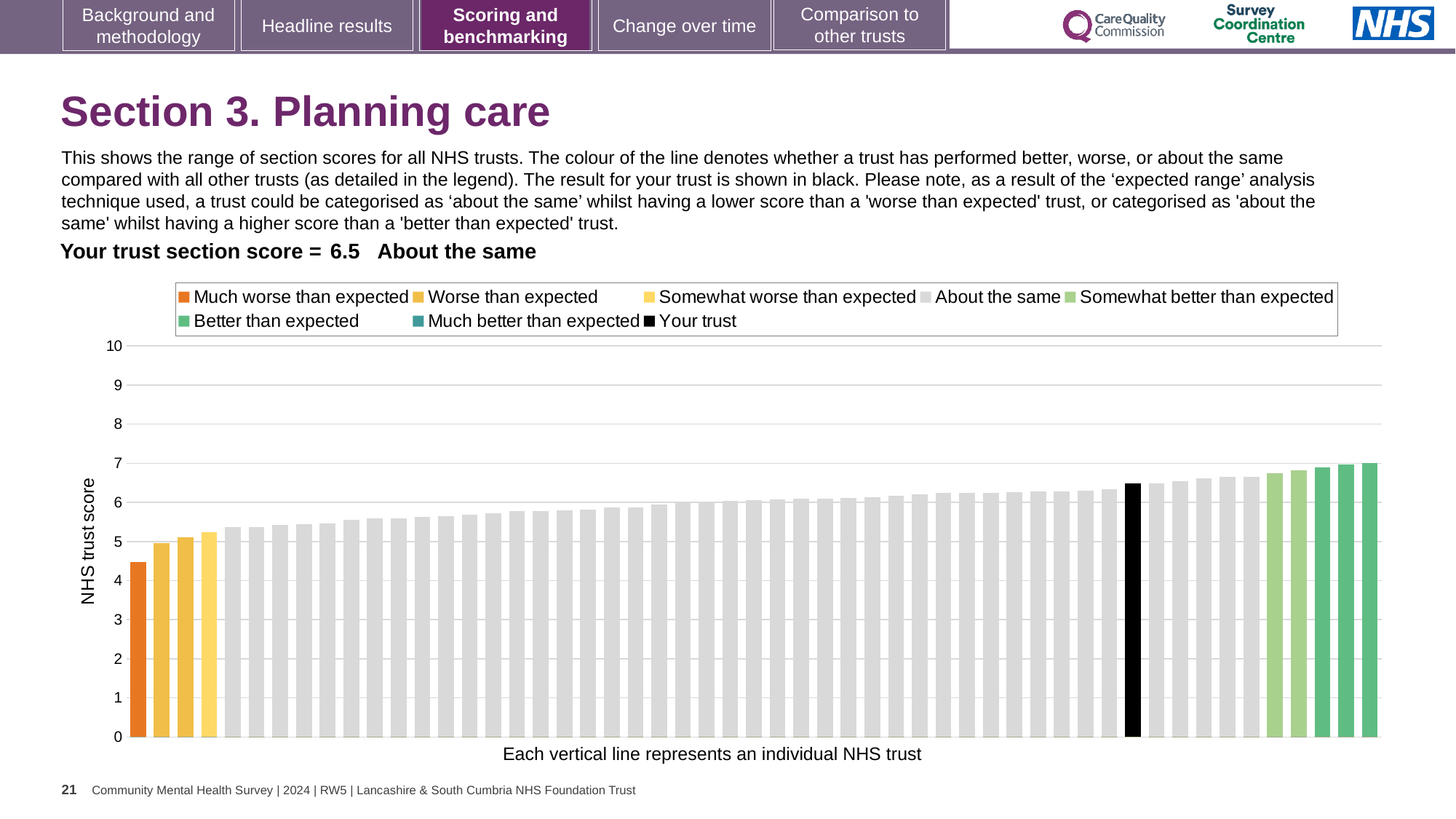
How many entries does the chart legend list? 8 Do the bar values rise or fall from left to right across the chart? rise Which legend category does the highest bar in the chart belong to? Better than expected Which legend category does the lowest bar in the chart belong to? Much worse than expected Which performance category is your trust placed in for this section? About the same How many bars are coloured as 'Better than expected' (green)? 3 Is the value of the lowest bar (the orange 'Much worse than expected' trust) greater or less than 5? less What is the label on the vertical axis of the chart? NHS trust score Is the value of the black 'Your trust' bar greater or less than 6? greater What kind of chart is shown on the slide? bar chart What is the section score for your trust shown on the slide? 6.5 How many bars are coloured as 'Much worse than expected' (orange)? 1